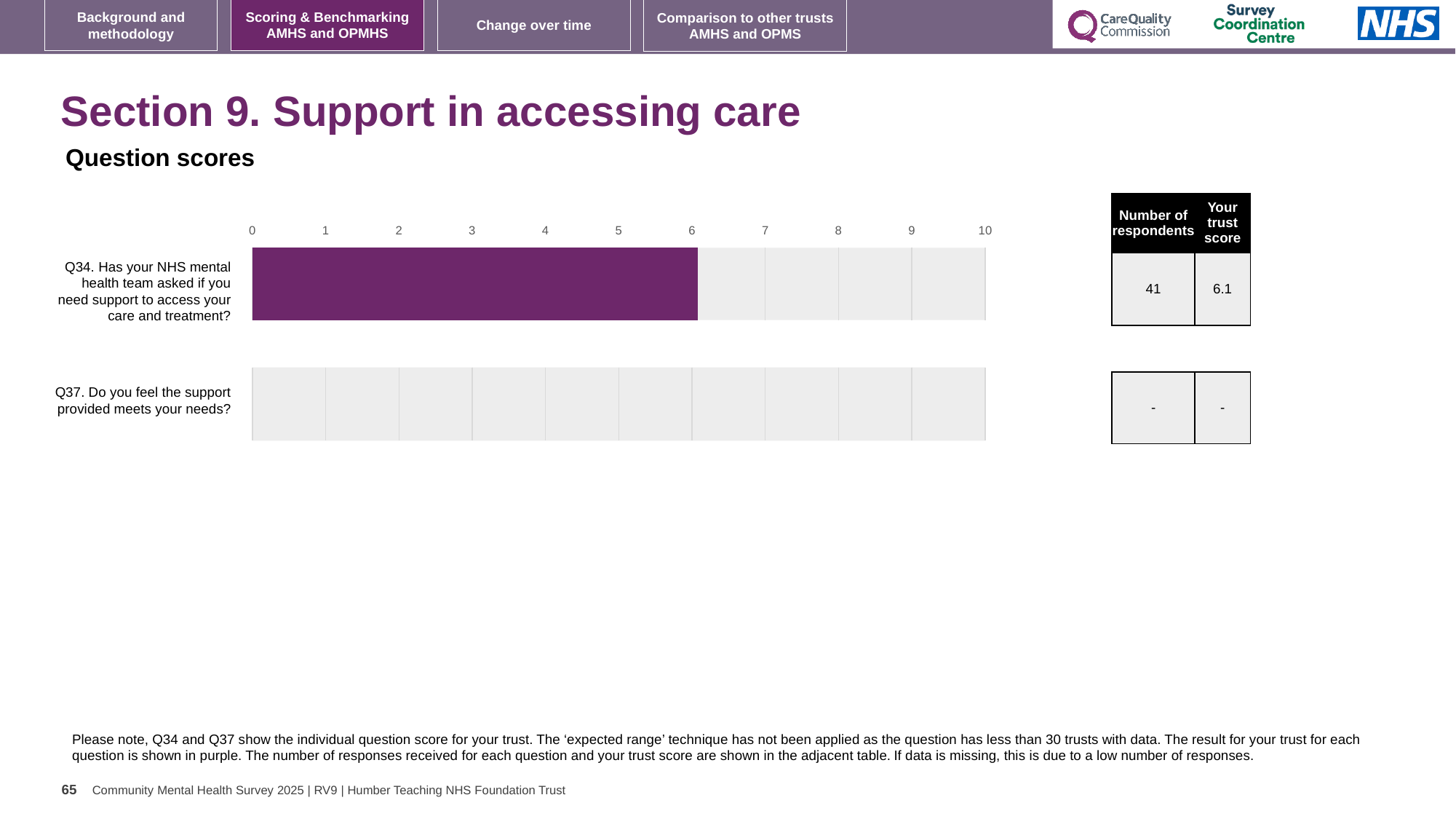
What is shown as the trust score for Q37 in the table? - How many respondents answered Q34 according to the table? 41 Is the bar for Q34 greater or less than 5 on the axis? greater What is the maximum value shown on the chart's axis? 10 Which question on the chart has no bar plotted? Q37 What kind of chart is used to show the question scores? Bar chart Is the bar for Q34 greater or less than 7 on the axis? less How many questions are listed on the chart? 2 What is the trust score for Q34 shown in the table next to the chart? 6.1